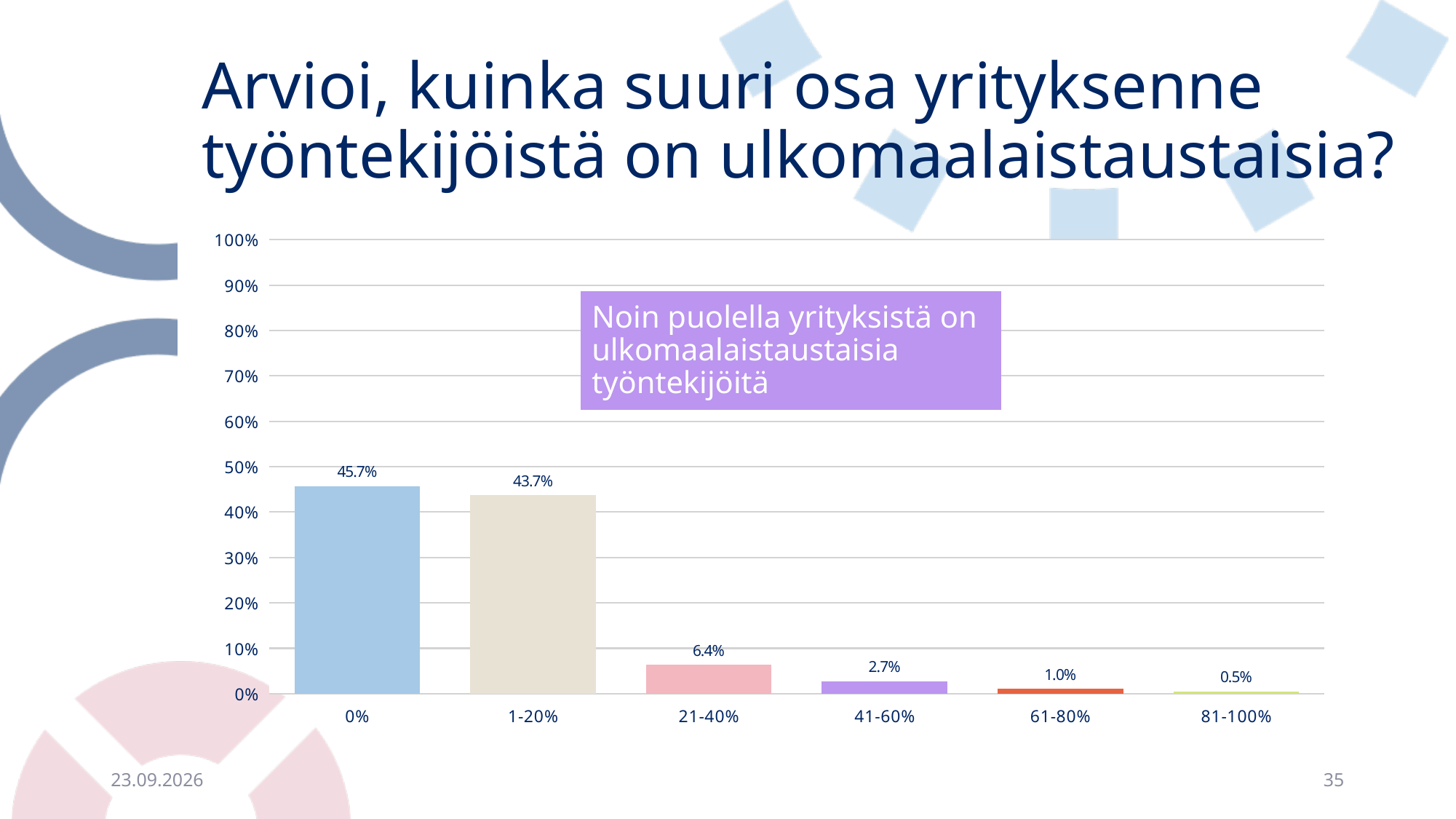
What is the value for the 1-20% category? 43.7% What kind of chart is shown on the slide? Bar chart What is the difference between the values for 21-40% and 41-60%? 3.7% What is the value for the 21-40% category? 6.4% Which category has the highest value? 0% What is the value for the 0% category? 45.7% What is the value for the 81-100% category? 0.5% What does the purple text box on the chart say? Noin puolella yrityksistä on ulkomaalaistaustaisia työntekijöitä How many categories are shown on the x axis? 6 Which category has the lowest value? 81-100% Which is larger, the value for 41-60% or the value for 61-80%? 41-60% What is the difference between the values for 0% and 1-20%? 2.0%